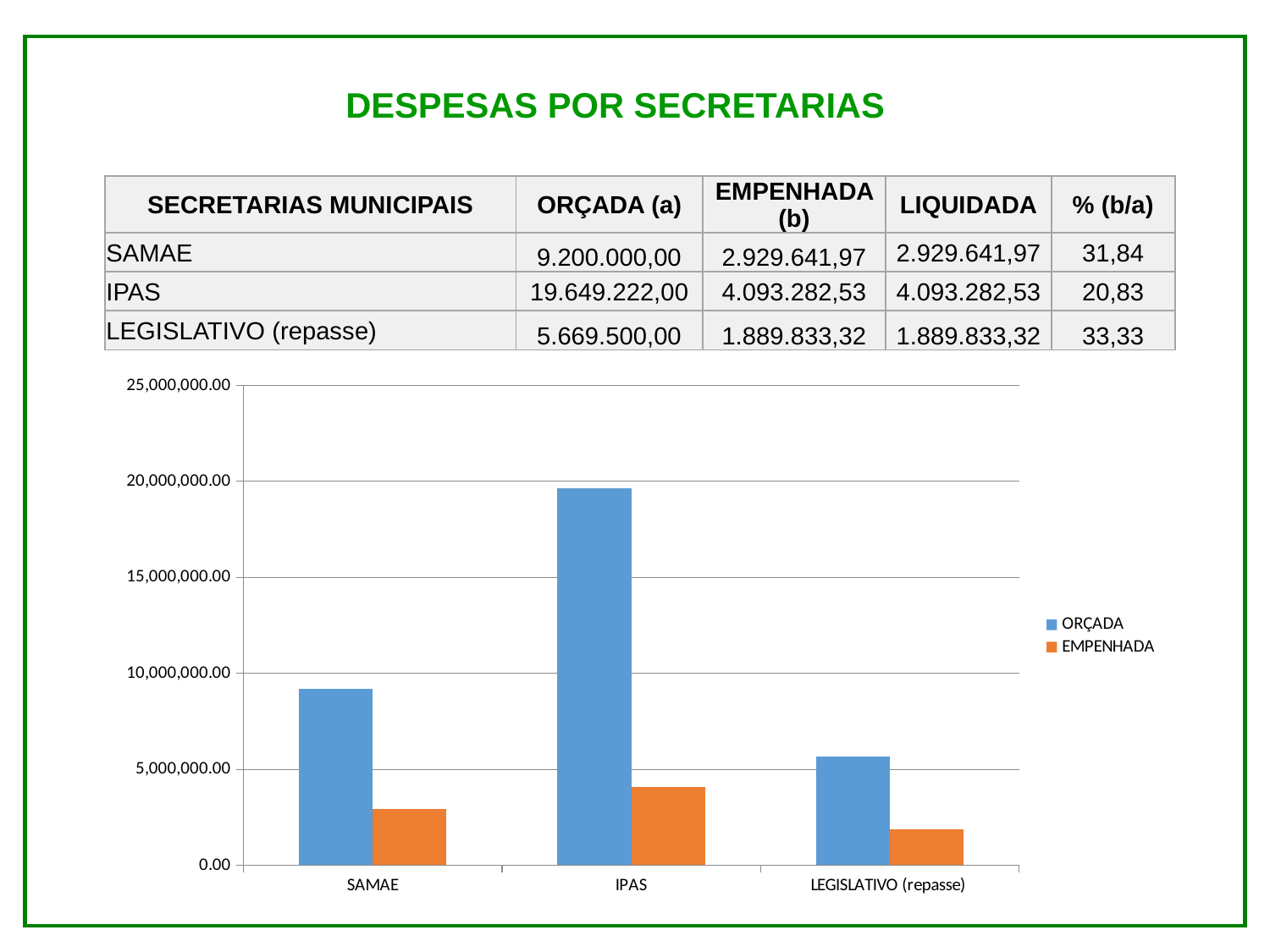
Which category has the highest ORÇADA bar in the chart? IPAS What is the ORÇADA value for IPAS? 19.649.222,00 Which category has the lowest EMPENHADA bar in the chart? LEGISLATIVO (repasse) What is the EMPENHADA value for SAMAE? 2.929.641,97 How many categories are shown on the x axis of the chart? 3 Which is larger, the ORÇADA value for SAMAE or the ORÇADA value for LEGISLATIVO (repasse)? SAMAE How many series does the chart legend list? 2 What is the difference between the ORÇADA values for IPAS and SAMAE? 10.449.222,00 Is the EMPENHADA value for LEGISLATIVO (repasse) greater or less than 5,000,000.00? less Is the ORÇADA value for IPAS greater or less than 15,000,000.00? greater What kind of chart is shown on the slide? bar chart Is the ORÇADA value for SAMAE greater or less than 10,000,000.00? less